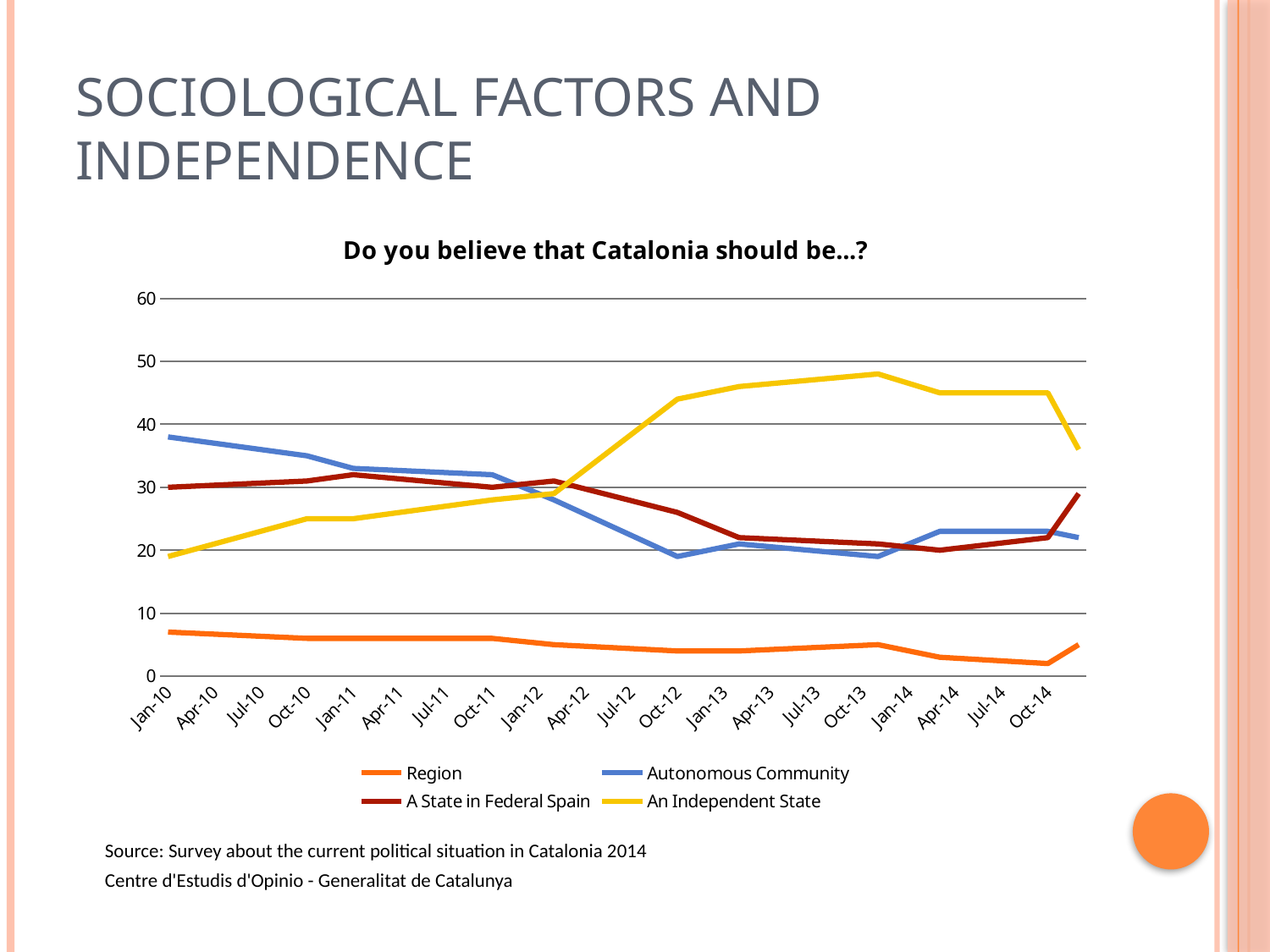
Which series has the lowest value at Jan-10? Region How many series does the legend list? 4 Does the An Independent State line rise or fall from Jan-10 to Oct-13? rise Is the value for A State in Federal Spain at Apr-14 greater or less than 30? less Is the value for An Independent State at Oct-13 greater or less than 40? greater What kind of chart is shown on the slide? line chart Which series has the highest value at Oct-13? An Independent State Is the value for Region at Jan-10 greater or less than 10? less How many time points are labelled on the x axis? 20 Does the Autonomous Community line rise or fall from Jan-10 to Oct-12? fall What is the title of the chart? Do you believe that Catalonia should be…?